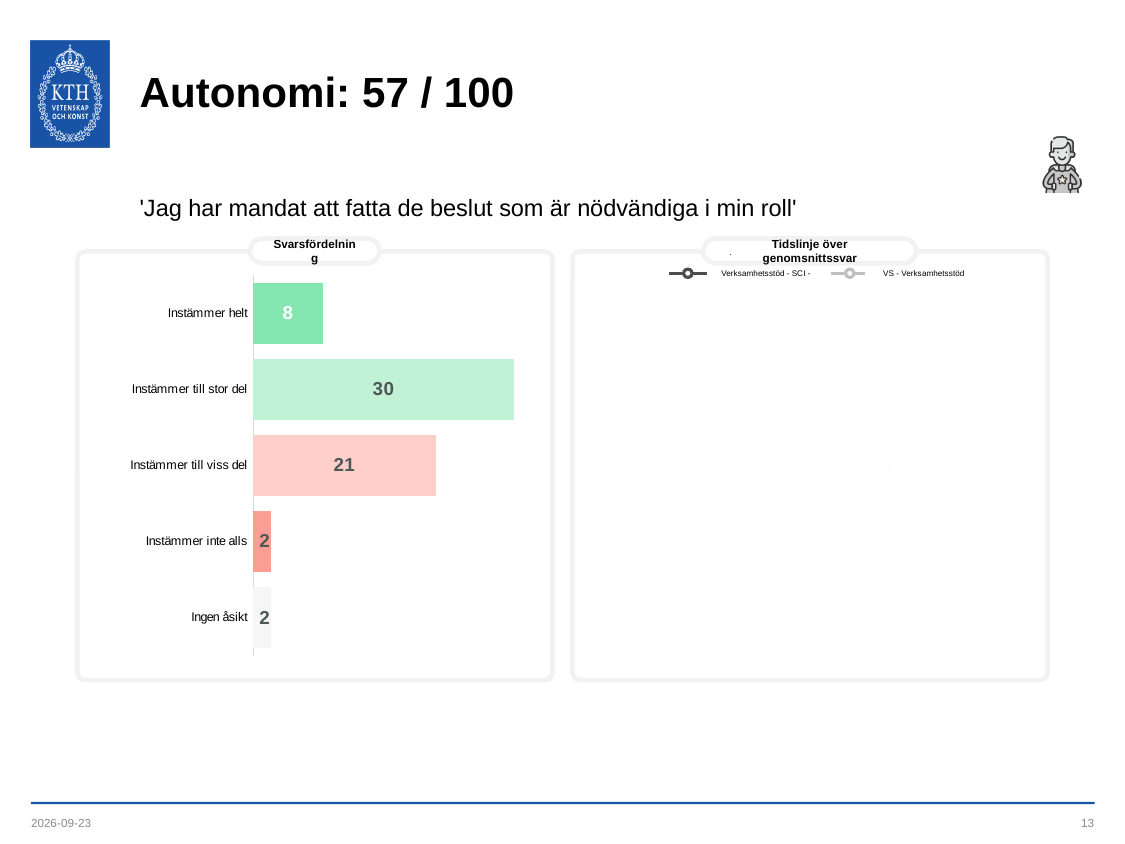
In the Svarsfördelning chart, which is larger: 'Instämmer helt' or 'Instämmer till viss del'? Instämmer till viss del In the Svarsfördelning chart, what is the value for 'Instämmer inte alls'? 2 In the Svarsfördelning chart, what is the difference between 'Instämmer till stor del' and 'Instämmer helt'? 22 What kind of chart is the Svarsfördelning chart? Bar chart In the Svarsfördelning chart, which category has the highest value? Instämmer till stor del In the Svarsfördelning chart, what is the difference between 'Instämmer till stor del' and 'Instämmer till viss del'? 9 In the Svarsfördelning chart, what is the value for 'Instämmer till viss del'? 21 How many entries does the legend of the 'Tidslinje över genomsnittssvar' chart list? 2 In the Svarsfördelning chart, what is the value for 'Instämmer helt'? 8 In the Svarsfördelning chart, what is the value for 'Instämmer till stor del'? 30 In the Svarsfördelning chart, what is the total of all five category values? 63 How many categories are shown in the Svarsfördelning chart? 5